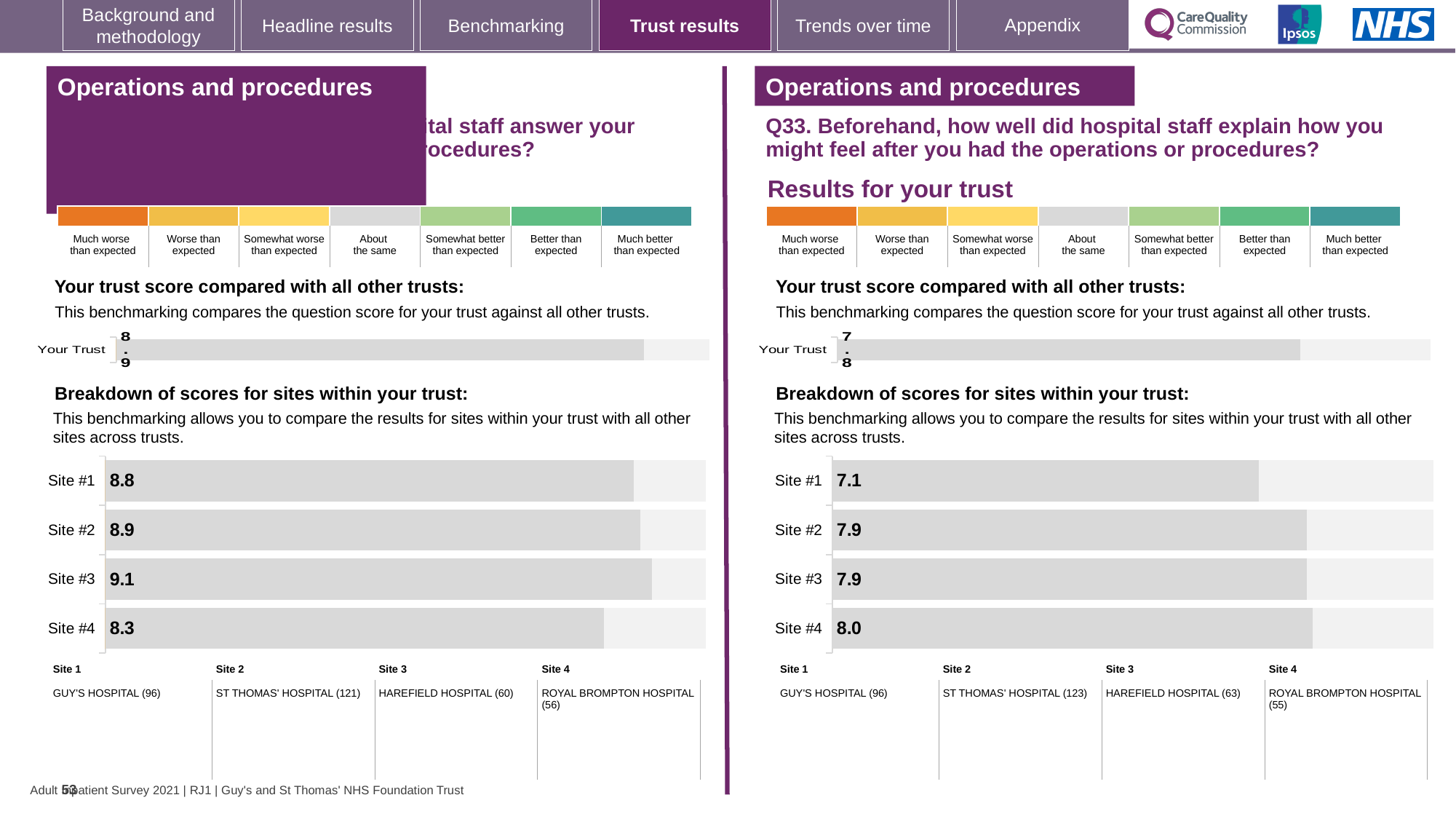
In the left-hand site breakdown chart, which site has the lowest score? Site #4 In the left-hand 'Breakdown of scores for sites within your trust' chart, what is the score for Site #3? 9.1 How many sites are shown in the right-hand (Q33) site breakdown chart? 4 What type of chart is the left-hand site breakdown chart? Bar chart In the right-hand (Q33) site breakdown chart, what is the score for Site #1? 7.1 In the left-hand site breakdown chart, which site has the highest score? Site #3 In the left-hand site breakdown chart, what is the difference between the scores for Site #3 and Site #4? 0.8 In the right-hand (Q33) site breakdown chart, what is the difference between the scores for Site #4 and Site #1? 0.9 In the left-hand 'Your trust score compared with all other trusts' chart, what is the score for Your Trust? 8.9 In the right-hand (Q33) site breakdown chart, which site has the lowest score? Site #1 In the right-hand (Q33) site breakdown chart, which site has the highest score? Site #4 In the right-hand (Q33) 'Your trust score compared with all other trusts' chart, what is the score for Your Trust? 7.8